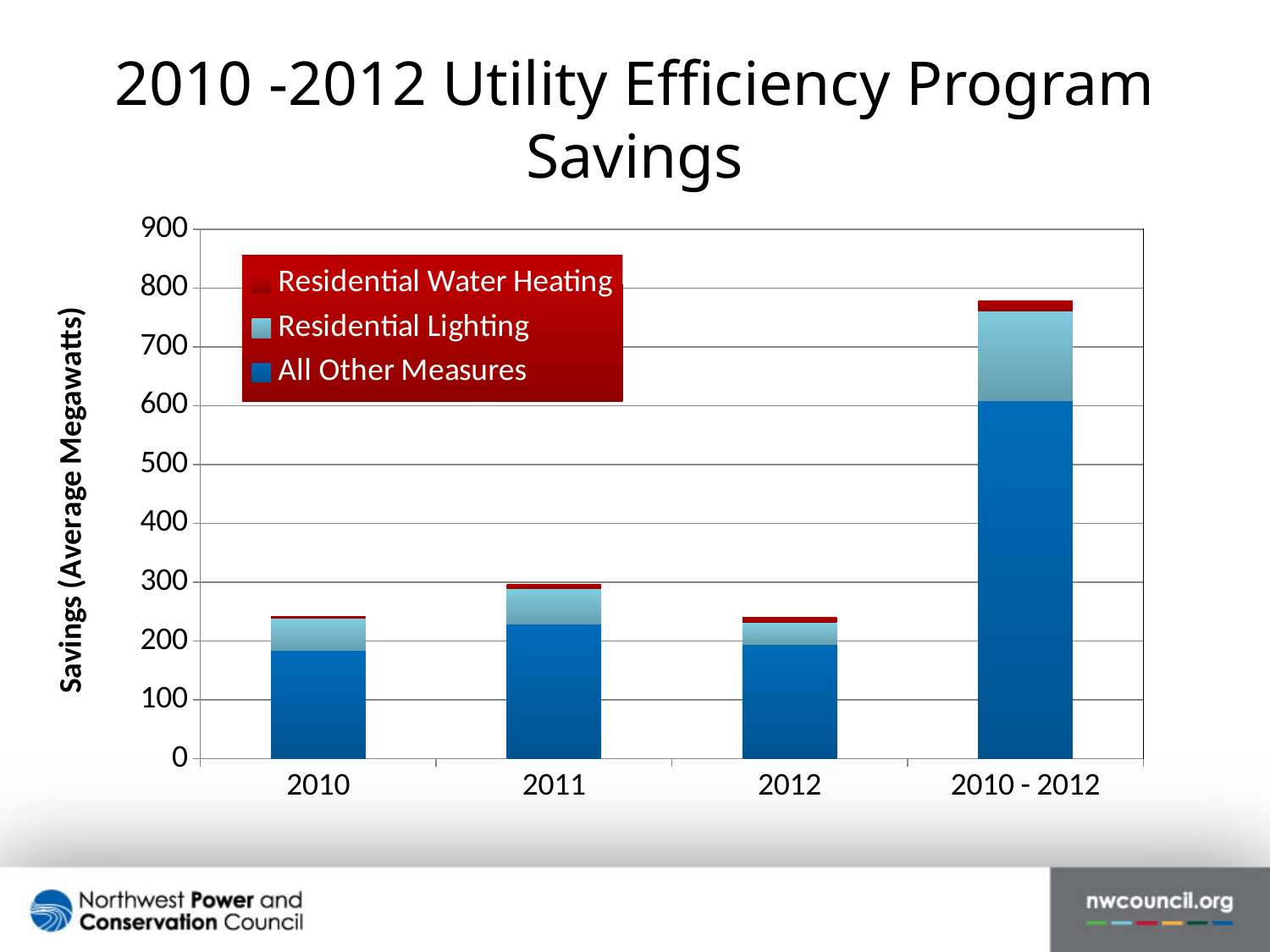
Which has the larger total stacked value, 2010 or 2011? 2011 Which category has the tallest stacked bar? 2010 - 2012 What is the label on the y axis? Savings (Average Megawatts) Is the All Other Measures value for 2010 - 2012 greater or less than 500? greater Is the All Other Measures value for 2012 greater or less than 100? greater Is the total stacked value for 2010 greater or less than 300? less What is the title of the chart? 2010 -2012 Utility Efficiency Program Savings How many categories are shown on the x axis? 4 How many series does the legend list? 3 What kind of chart is shown on the slide? stacked bar chart